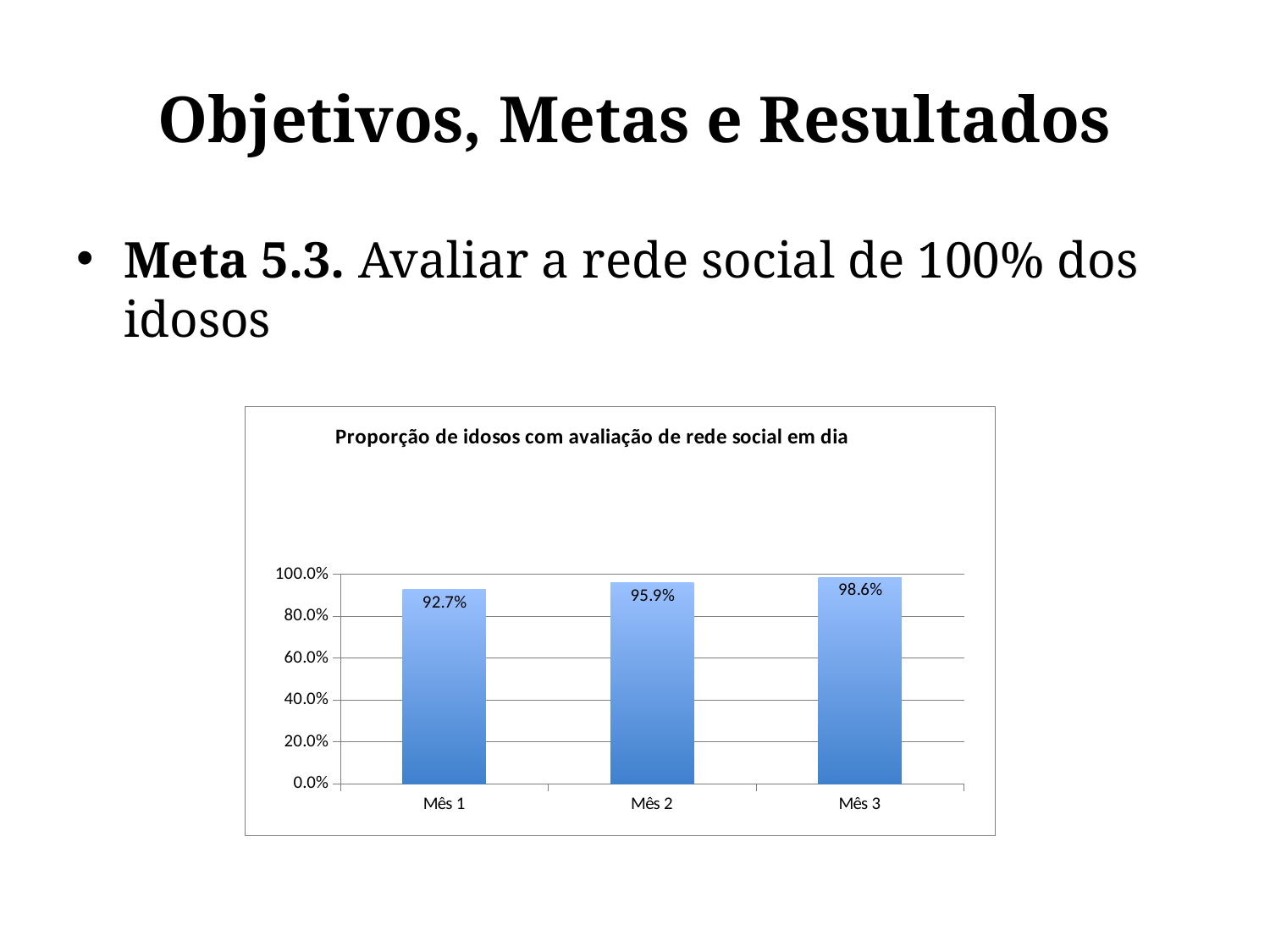
What is the value for Mês 3? 98.6% What is the value for Mês 1? 92.7% What is the difference between the values for Mês 2 and Mês 1? 3.2% How many months are shown on the x axis? 3 Which month has the highest value? Mês 3 Which is larger, the value for Mês 2 or the value for Mês 3? Mês 3 Which month has the lowest value? Mês 1 Is the value for Mês 1 greater or less than 80.0%? greater What kind of chart is shown? bar chart What is the difference between the values for Mês 3 and Mês 1? 5.9% Do the values rise or fall from Mês 1 to Mês 3? rise What is the value for Mês 2? 95.9%